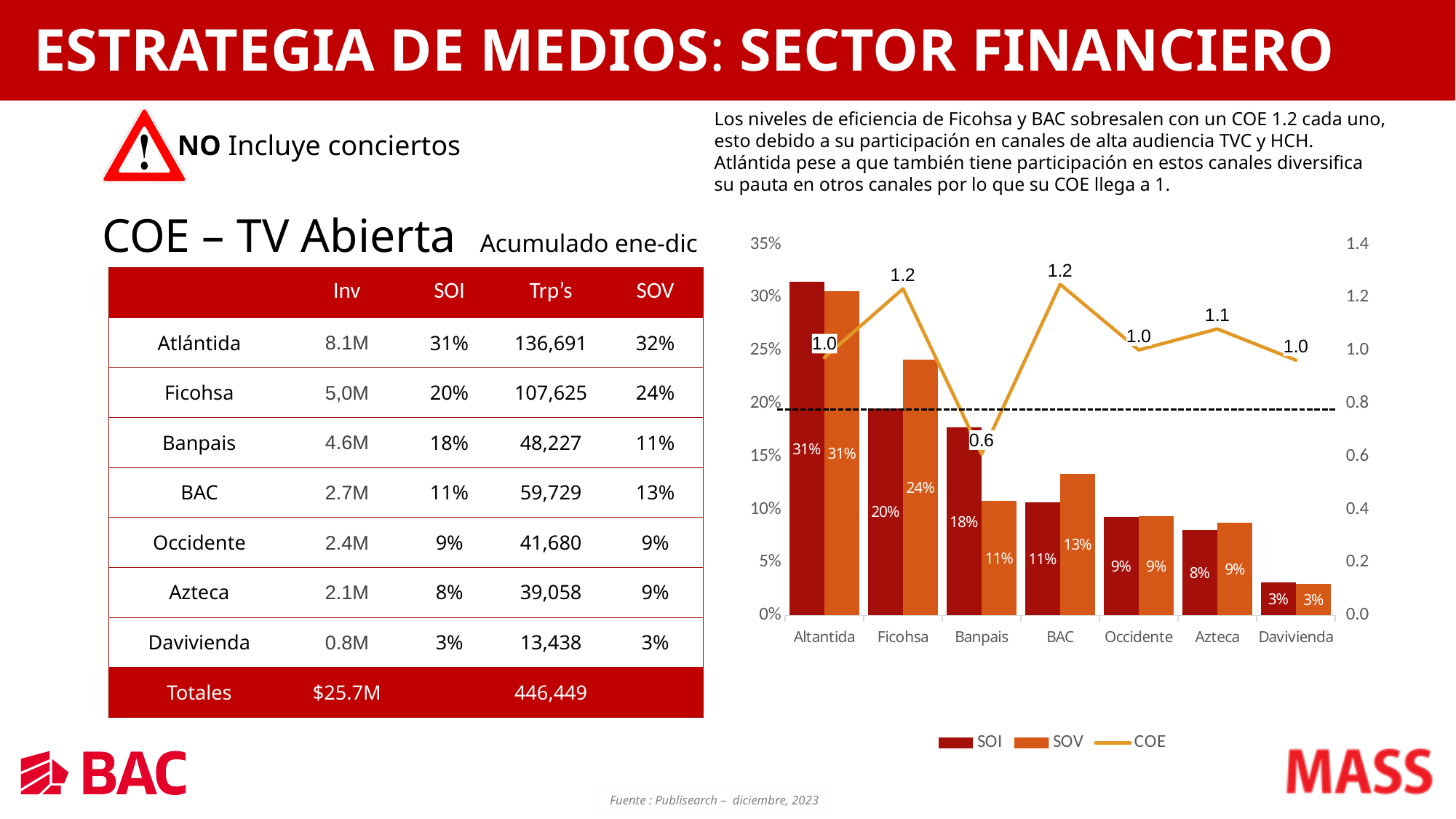
How many series does the legend list? 3 What kind of chart is shown on the slide? Combined bar and line chart What is the COE value for Banpais? 0.6 Which is larger for Banpais, SOI or SOV? SOI Do the SOI values rise or fall from Altantida to Davivienda? Fall What is the COE value for Azteca? 1.1 What is the SOI value for Ficohsa? 20% Which category has the lowest COE? Banpais What is the SOV value for BAC? 13% What is the difference between the SOV and SOI values for Ficohsa? 4% How many categories are shown on the x axis? 7 Which category has the highest SOI? Altantida